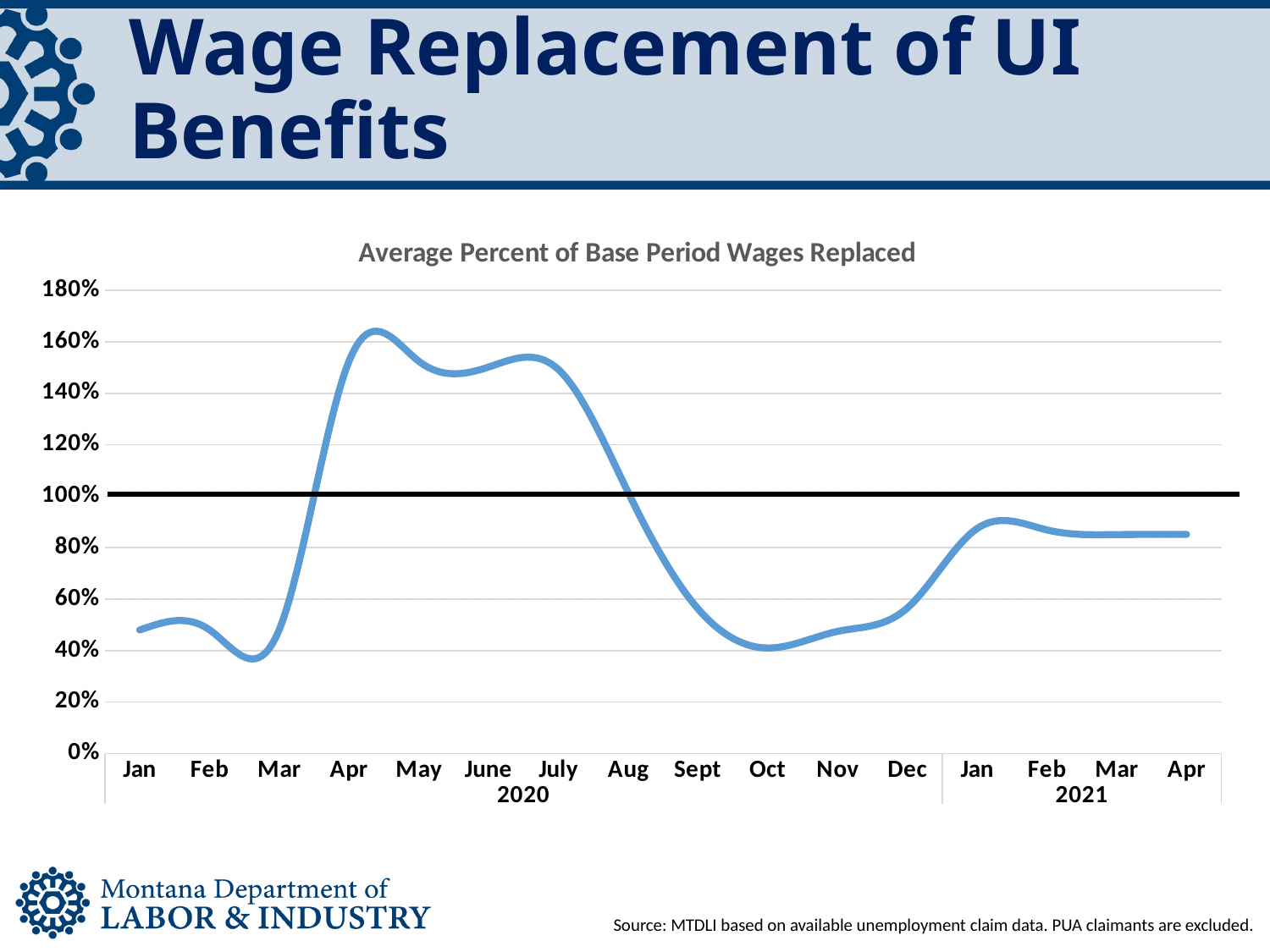
What is the title of the chart? Average Percent of Base Period Wages Replaced How many monthly data points are plotted on the chart? 16 Is the value for Jan 2021 greater or less than 100%? less Which is larger, the value for Apr 2020 or the value for Jan 2021? Apr 2020 Is the value for Jan 2020 greater or less than 60%? less Do the values rise or fall from Apr 2020 to Oct 2020? fall Which month has the highest average percent of base period wages replaced? Apr 2020 Which is larger, the value for Mar 2020 or the value for June 2020? June 2020 What kind of chart is shown on the slide? line chart Is the value for July 2020 greater or less than 140%? greater